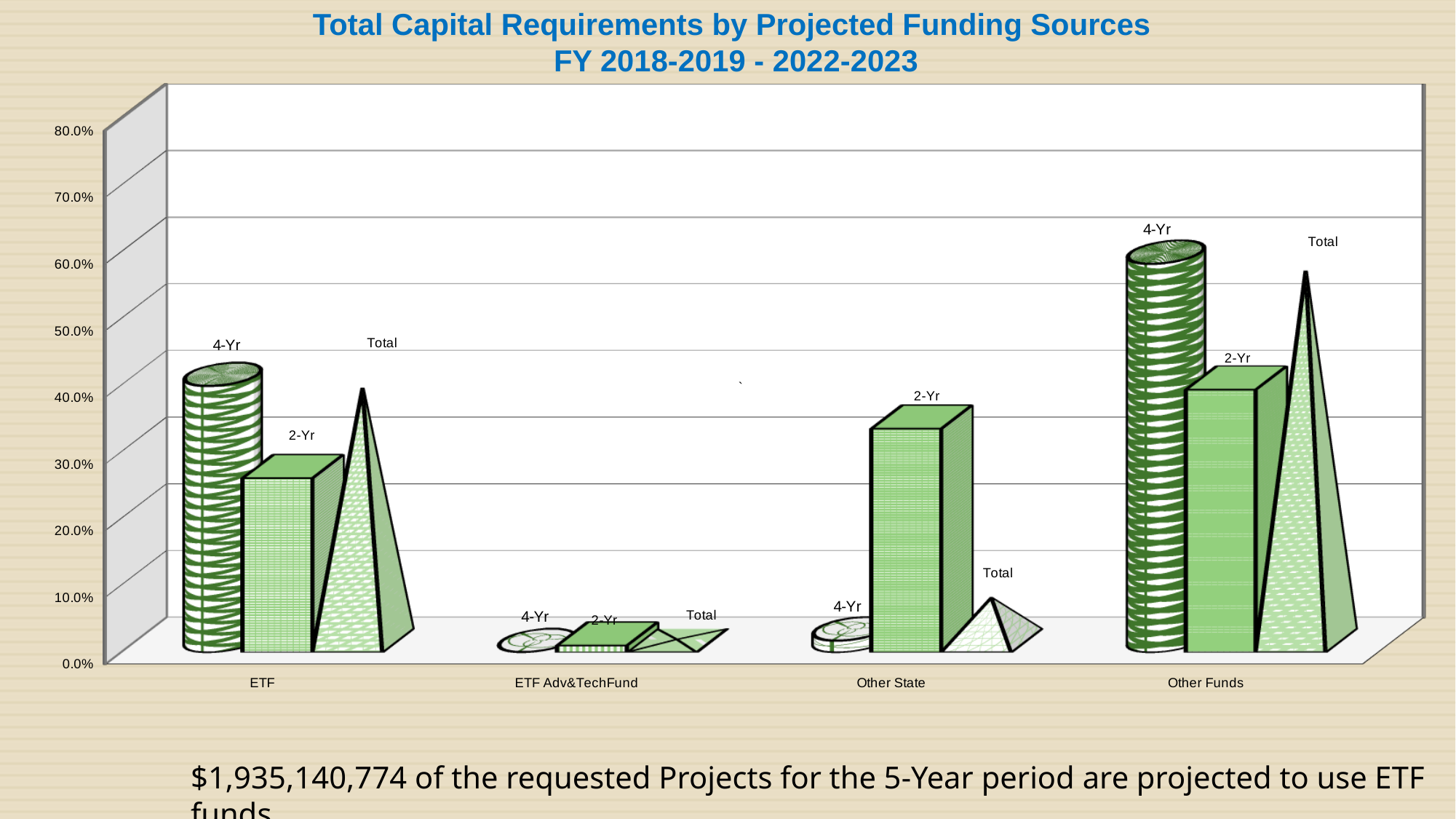
Which funding source has the highest 4-Yr value? Other Funds For ETF, which is larger: the 4-Yr value or the 2-Yr value? 4-Yr For Other State, which is larger: the 2-Yr value or the Total value? 2-Yr Is the 4-Yr value for ETF greater or less than 30.0%? greater Which funding source has the highest Total value? Other Funds What kind of chart is shown on the slide? Bar chart Is the 4-Yr value for Other Funds greater or less than 50.0%? greater How many funding source categories are shown on the x axis? 4 Which funding source has the lowest Total value? ETF Adv&TechFund Is the 4-Yr value for Other State greater or less than 10.0%? less How many data series (4-Yr, 2-Yr, Total) are plotted for each funding source? 3